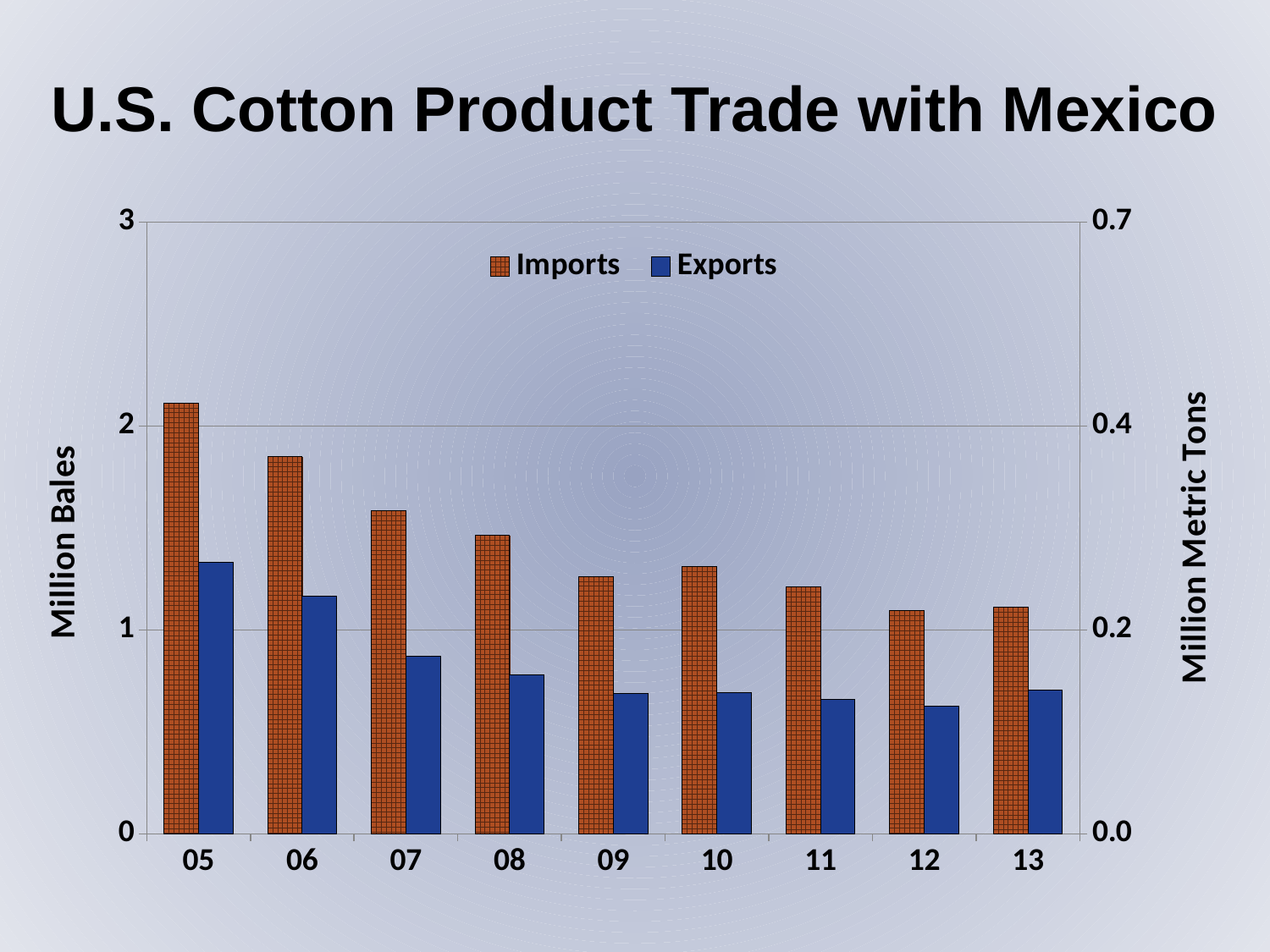
Is the Imports value for 06 greater or less than 2? less Is the Exports value for 07 greater or less than 1? less What is the title of the chart? U.S. Cotton Product Trade with Mexico In which year are Imports highest? 05 How many series does the legend list? 2 What kind of chart is shown on the slide? Bar chart In which year are Exports highest? 05 Do Imports generally rise or fall from 05 to 13? Fall Is the Exports value for 05 greater or less than 1? greater How many years are shown on the x axis? 9 Which is larger, Imports in 05 or Imports in 13? Imports in 05